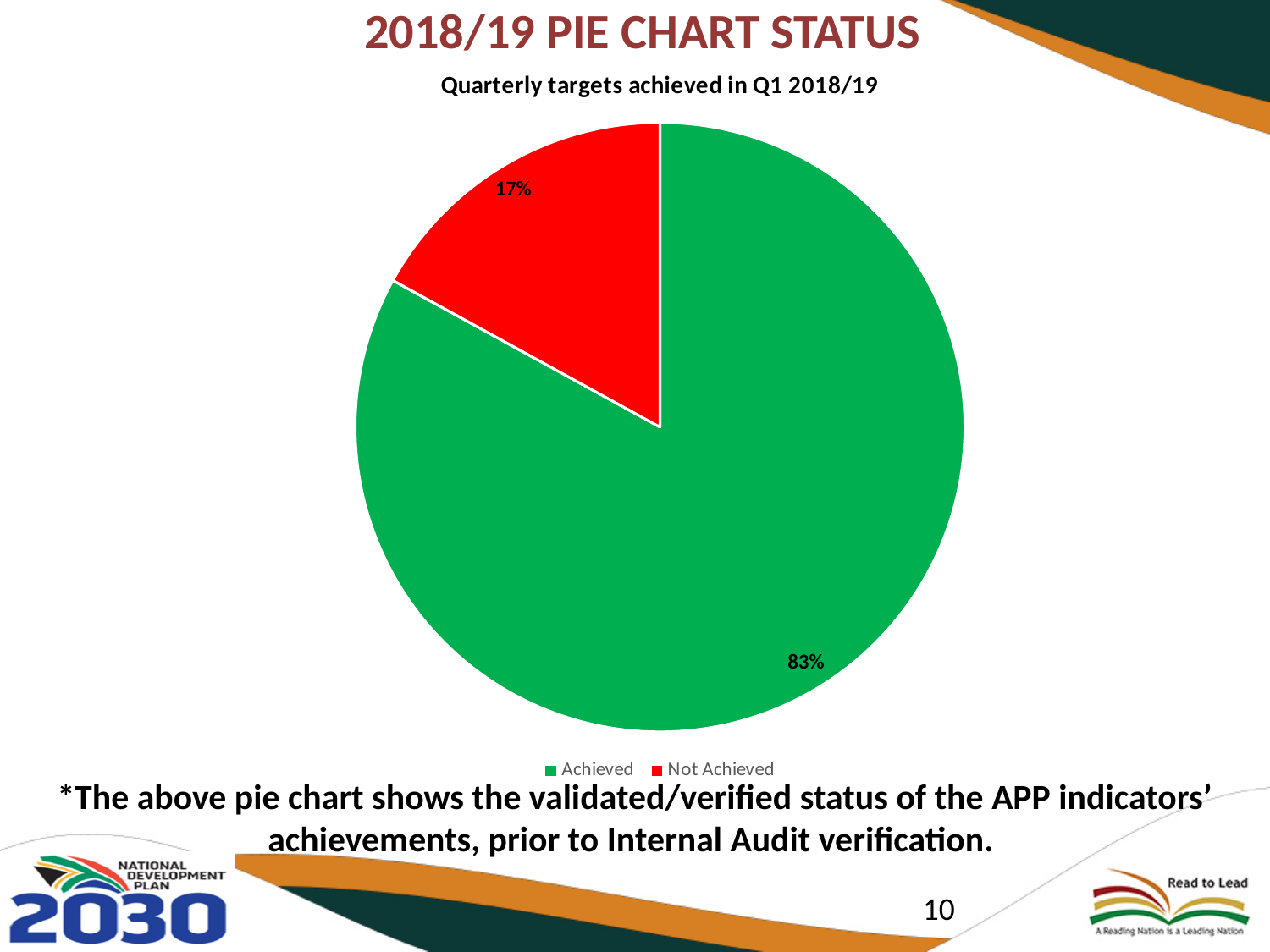
What is the title of the chart? Quarterly targets achieved in Q1 2018/19 Which category has the largest share of the pie? Achieved Which category has the smallest share of the pie? Not Achieved What kind of chart is shown on the slide? pie chart Is the share for Achieved larger or smaller than the share for Not Achieved? larger What colour represents the Not Achieved slice? red How many entries does the legend list? 2 How many categories does the pie chart show? 2 What is the difference in percentage points between the Achieved and Not Achieved shares? 66 What percentage of quarterly targets were not achieved in Q1 2018/19? 17% What percentage of quarterly targets were achieved in Q1 2018/19? 83%